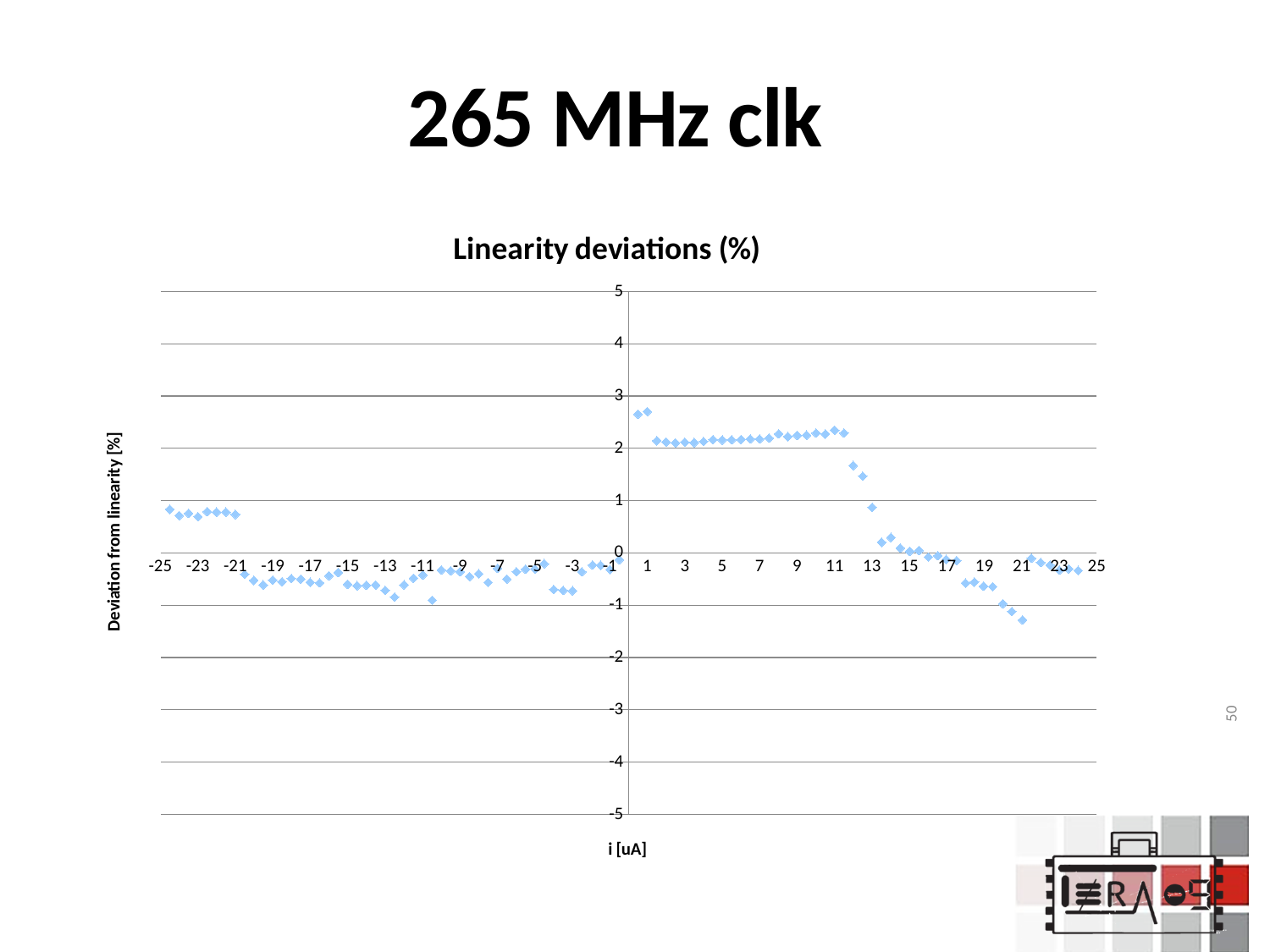
Is the value for i = -24 uA greater or less than 0? greater Is the value for i = 1 uA greater or less than 2? greater Is the value for i = 21 uA greater or less than -1? less What is the label of the x axis? i [uA] Which is larger, the value at i = 1 uA or the value at i = -1 uA? i = 1 uA Do the values rise or fall as i increases from 11 uA to 21 uA? fall Around which x value does the highest point of the chart occur? 1 What is the title of the chart? Linearity deviations (%) What kind of chart is shown on the slide? scatter chart